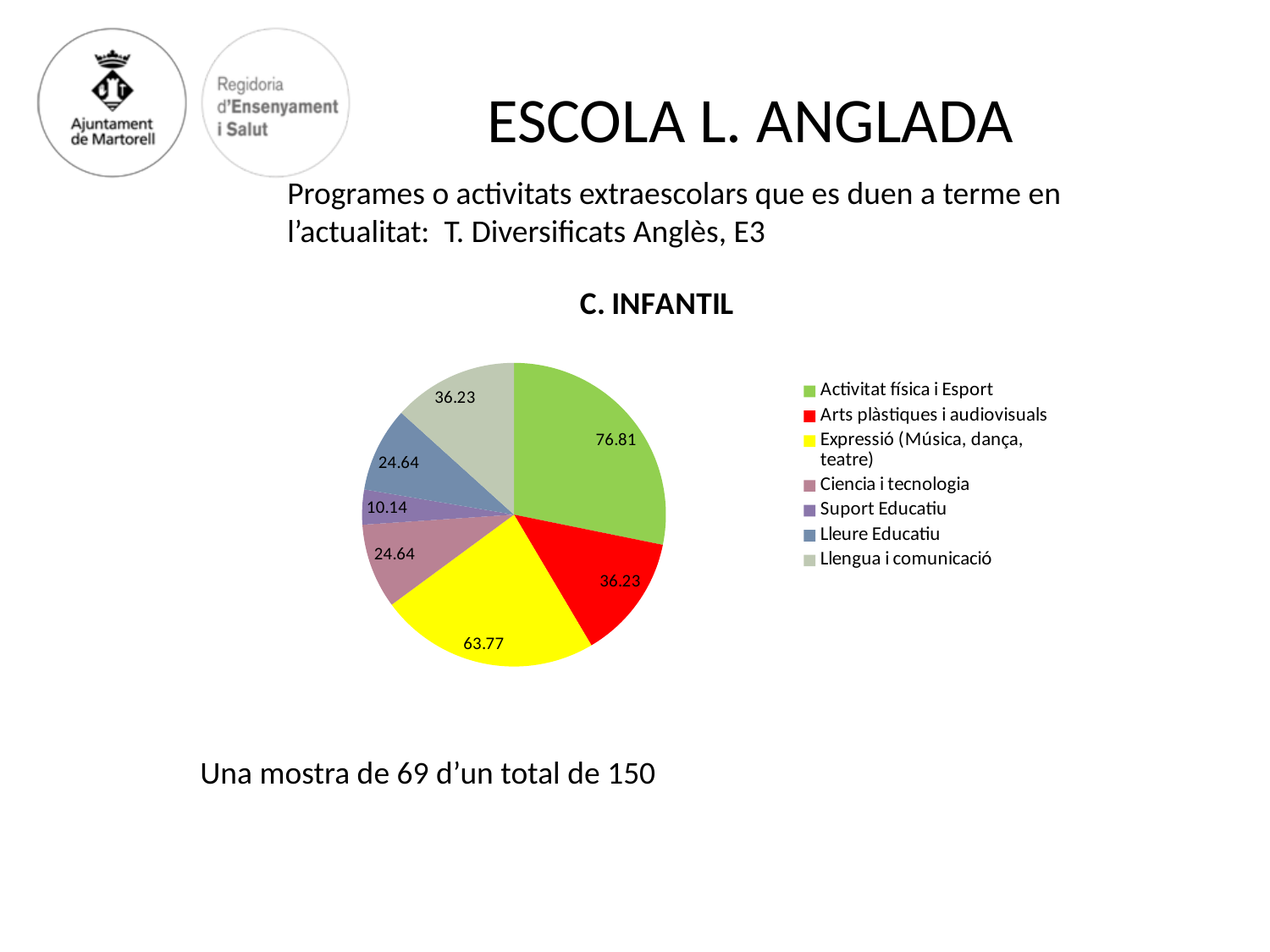
How many slices does the C. INFANTIL pie chart have? 7 In the C. INFANTIL pie chart, which is larger: Expressió (Música, dança, teatre) or Arts plàstiques i audiovisuals? Expressió (Música, dança, teatre) What is the difference between the values for Llengua i comunicació and Suport Educatiu in the C. INFANTIL pie chart? 26.09 Which category has the smallest slice in the C. INFANTIL pie chart? Suport Educatiu Which category has the largest slice in the C. INFANTIL pie chart? Activitat física i Esport What is the value shown for Activitat física i Esport in the C. INFANTIL pie chart? 76.81 Which colour represents Arts plàstiques i audiovisuals in the C. INFANTIL pie chart? Red What is the value shown for Expressió (Música, dança, teatre) in the C. INFANTIL pie chart? 63.77 What type of chart is shown under the heading C. INFANTIL? Pie chart What is the difference between the values for Activitat física i Esport and Expressió (Música, dança, teatre) in the C. INFANTIL pie chart? 13.04 What is the value shown for Lleure Educatiu in the C. INFANTIL pie chart? 24.64 What is the value shown for Suport Educatiu in the C. INFANTIL pie chart? 10.14